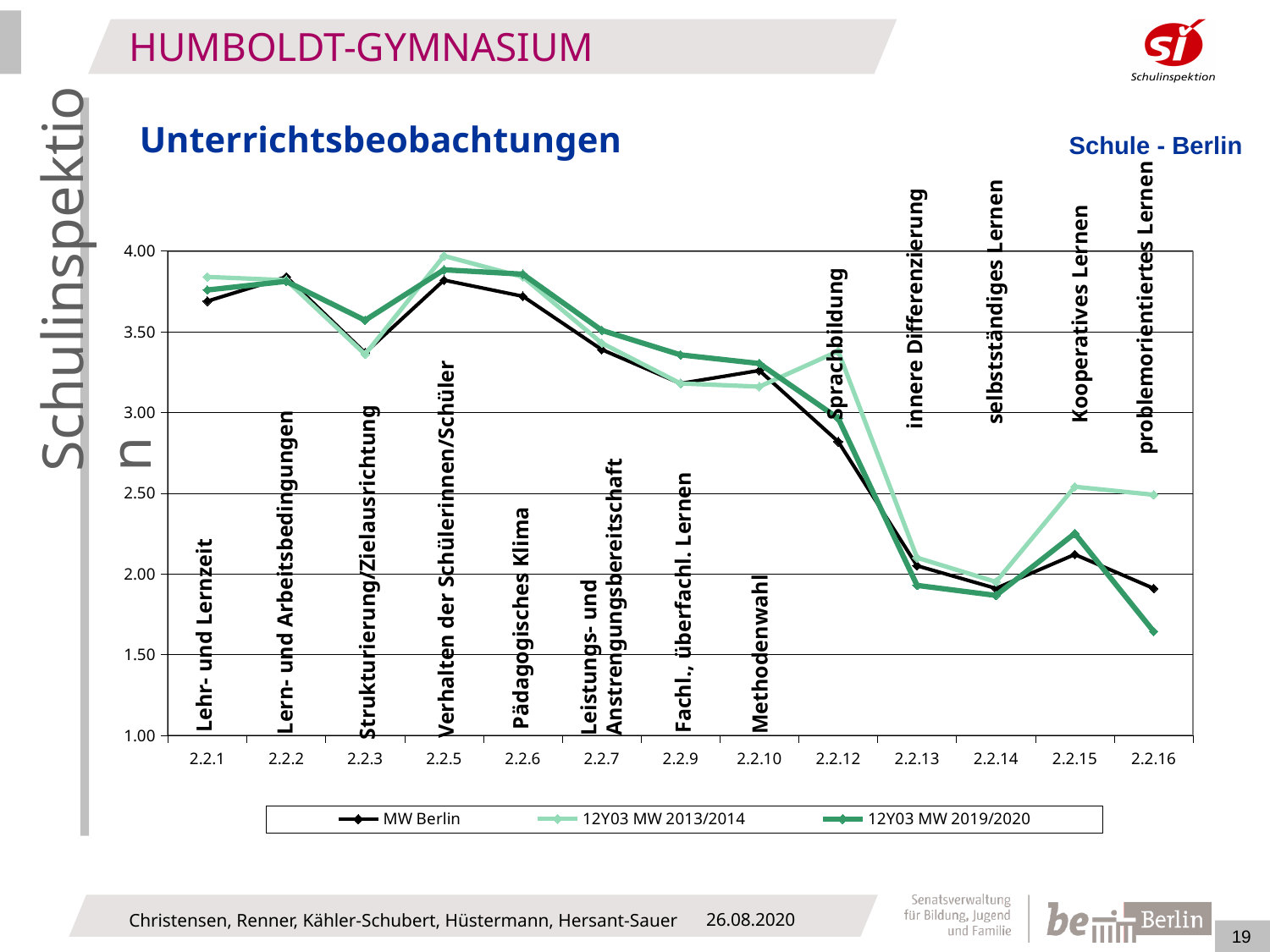
How many series does the legend list? 3 Is the value of 12Y03 MW 2013/2014 at 2.2.3 greater or less than 3.50? less What is the title of the chart? Unterrichtsbeobachtungen What kind of chart is shown on the slide? line chart At 2.2.12, which series has the higher value: MW Berlin or 12Y03 MW 2013/2014? 12Y03 MW 2013/2014 Do the values of the series generally rise or fall from 2.2.1 to 2.2.16? fall At which category does the 12Y03 MW 2019/2020 series reach its lowest value? 2.2.16 Is the value of 12Y03 MW 2013/2014 at 2.2.12 greater or less than 3.00? greater At which category does the 12Y03 MW 2013/2014 series reach its highest value? 2.2.5 Is the value of 12Y03 MW 2019/2020 at 2.2.16 greater or less than 2.00? less How many categories are shown on the x axis? 13